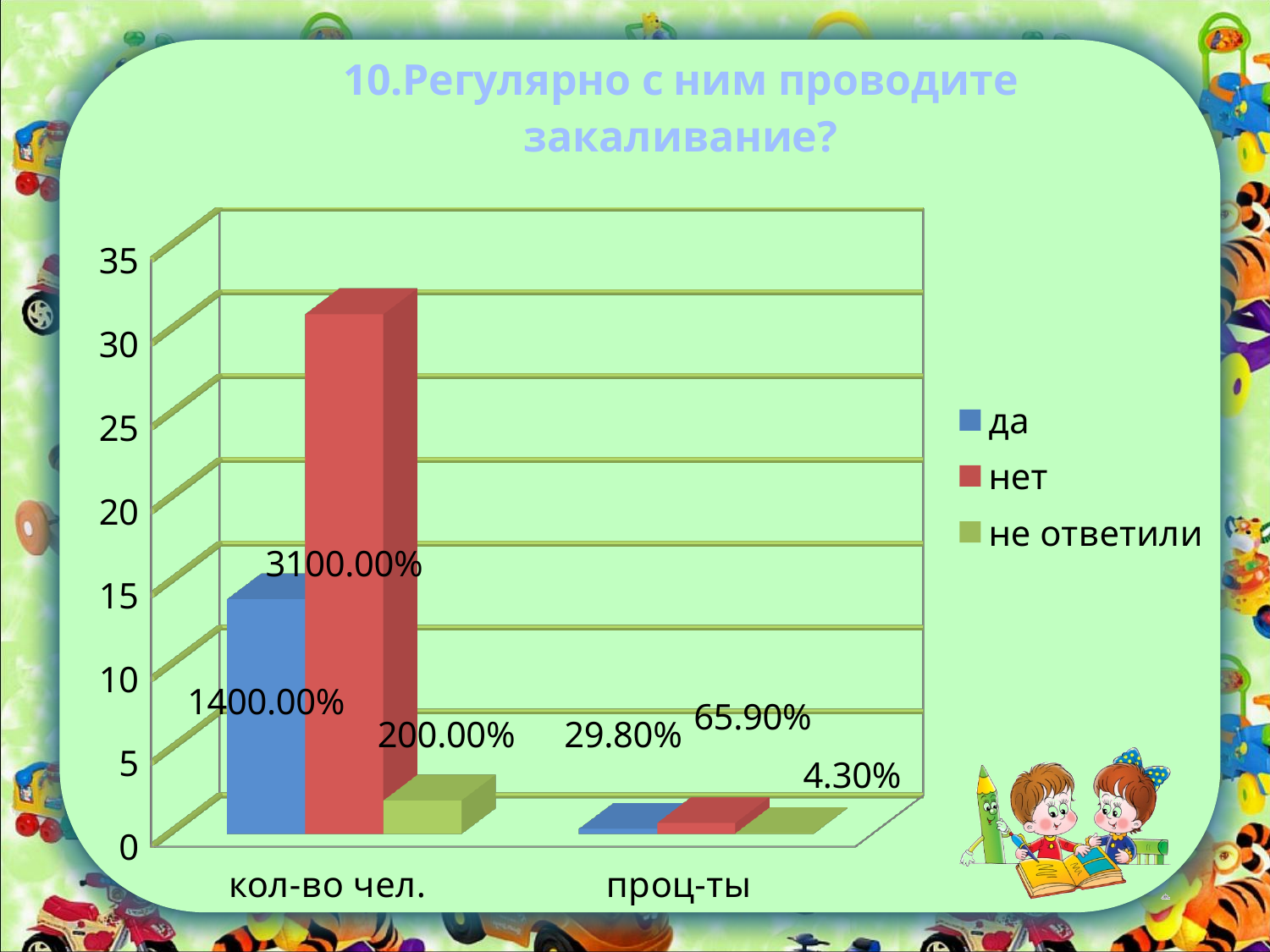
In the "кол-во чел." category, which is larger: "да" or "нет"? нет What type of chart is shown on the slide? bar chart What is the data label for "не ответили" in the "кол-во чел." category? 200.00% What is the difference between the "нет" and "да" labels in the "проц-ты" category? 36.10% Is the "да" bar in the "кол-во чел." category greater or less than 20 on the axis? less Which series has the tallest bar in the "кол-во чел." category? нет What is the data label for "нет" in the "проц-ты" category? 65.90% What is the data label for "да" in the "кол-во чел." category? 1400.00% How many series does the legend list? 3 What is the data label for "да" in the "проц-ты" category? 29.80% Which series has the smallest value in the "проц-ты" category? не ответили How many categories are shown on the x axis? 2